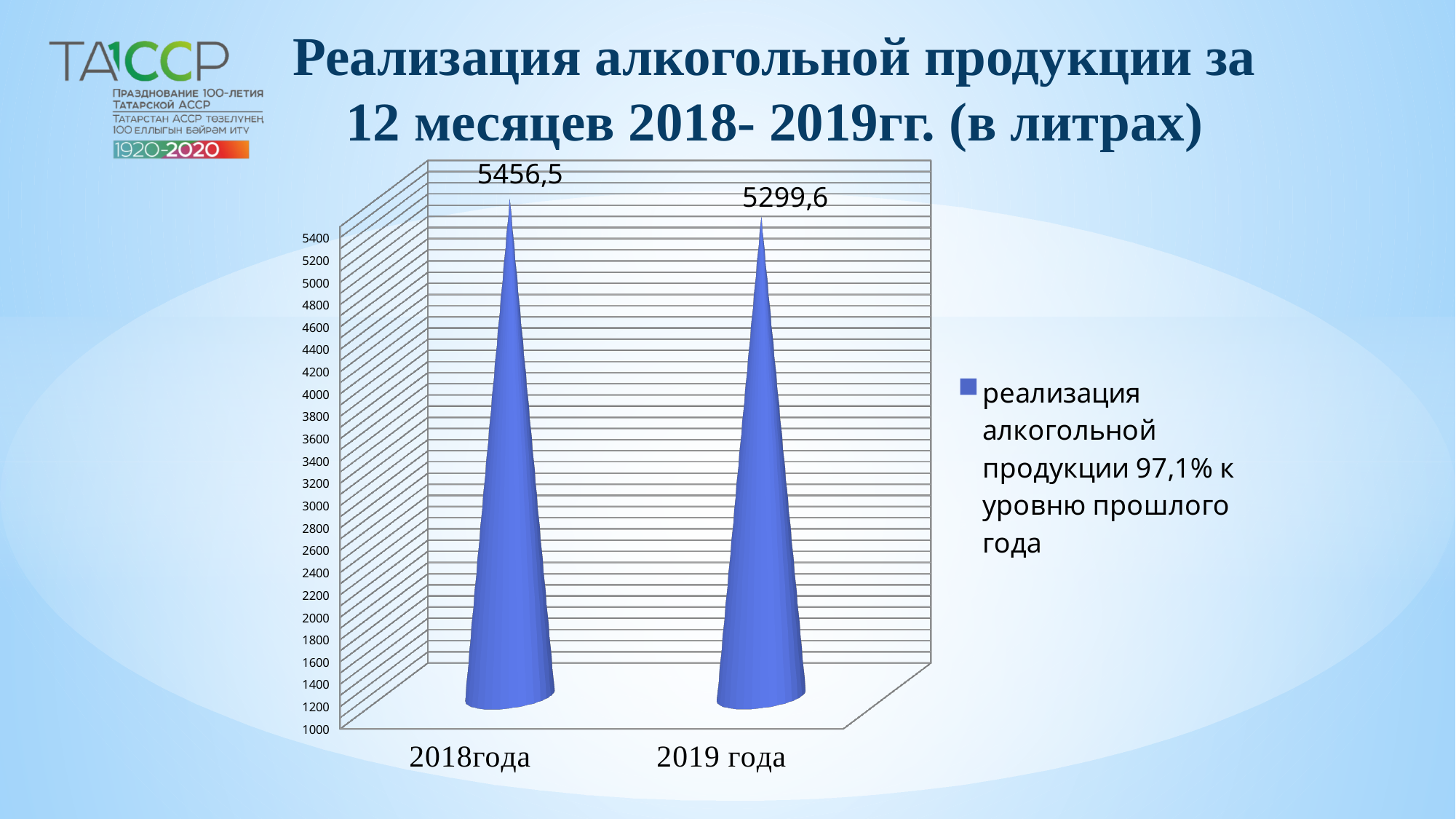
How many categories are shown on the x axis? 2 What is the value for 2018 года? 5456,5 Which year has the lowest value? 2019 года Which year has the highest value? 2018 года Which is larger, the value for 2018 года or the value for 2019 года? 2018 года What kind of chart is shown on the slide? bar chart What is the value for 2019 года? 5299,6 How many series does the legend list? 1 What is the title of the chart? Реализация алкогольной продукции за 12 месяцев 2018- 2019гг. (в литрах) Is the value for 2019 года greater or less than 5000? greater What is the difference between the values for 2018 года and 2019 года? 156,9 Do the values rise or fall from 2018 года to 2019 года? fall